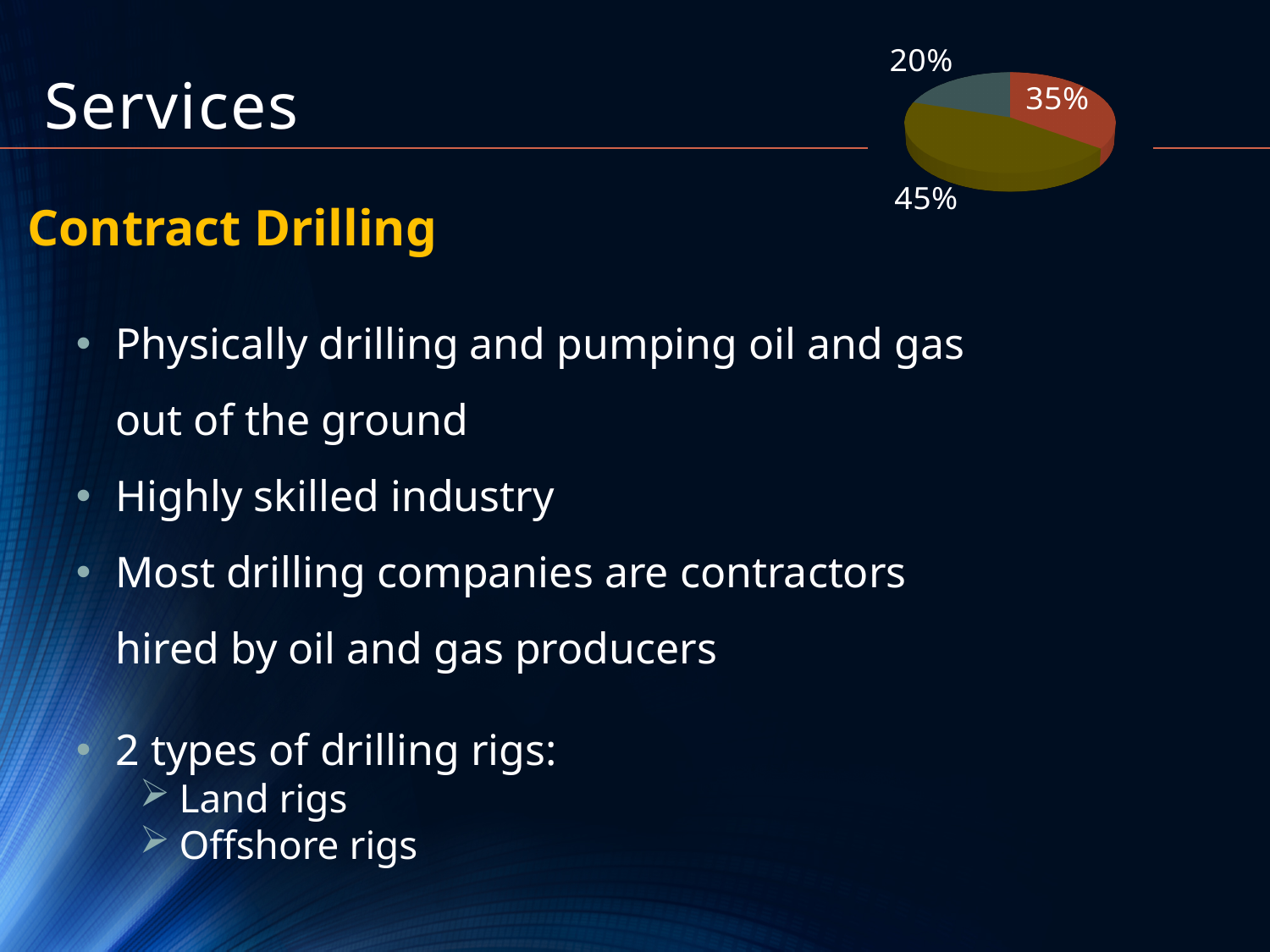
What is the value of the olive-coloured slice in the pie chart? 45% What do the three slice labels in the pie chart add up to? 100% What kind of chart is shown on the slide? pie chart Which is larger in the pie chart, the red slice or the dark grey slice? the red slice What colour is the 35% slice in the pie chart? red What is the value of the largest slice in the pie chart? 45% Does the pie chart have a legend? no What is the value of the smallest slice in the pie chart? 20% What is the difference between the largest and smallest slices in the pie chart? 25% What is the difference between the 45% slice and the 35% slice in the pie chart? 10% How many slices does the pie chart have? 3